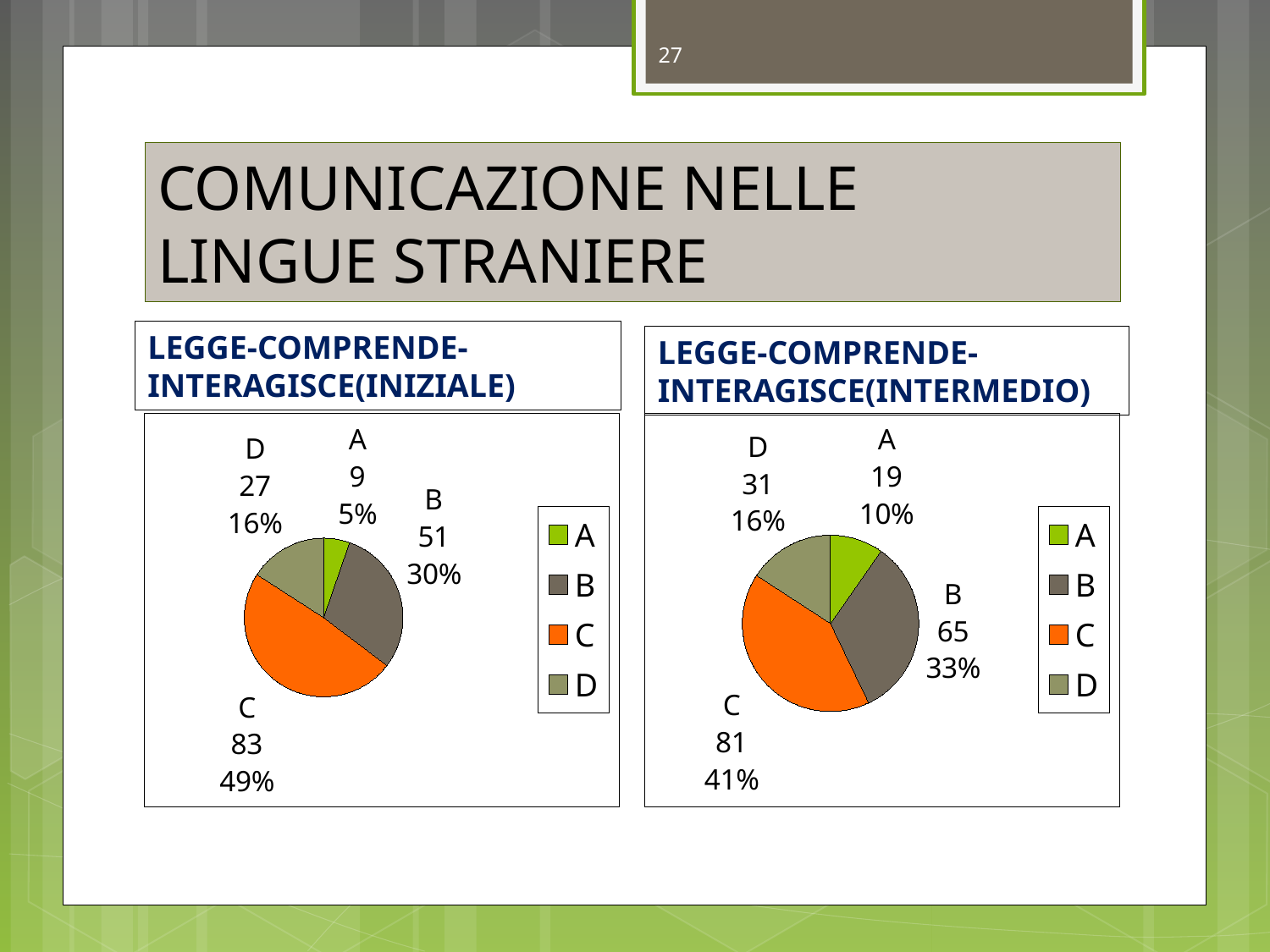
In the LEGGE-COMPRENDE-INTERAGISCE(INTERMEDIO) chart, which is larger, the value for D or the value for A? D In the LEGGE-COMPRENDE-INTERAGISCE(INTERMEDIO) chart, what is the total of all four values? 196 In the LEGGE-COMPRENDE-INTERAGISCE(INIZIALE) chart, which category has the largest slice? C In the LEGGE-COMPRENDE-INTERAGISCE(INTERMEDIO) chart, which category has the smallest slice? A In the LEGGE-COMPRENDE-INTERAGISCE(INIZIALE) chart, what is the value for C? 83 In the LEGGE-COMPRENDE-INTERAGISCE(INTERMEDIO) chart, what percentage share does A have? 10% How many categories does the LEGGE-COMPRENDE-INTERAGISCE(INIZIALE) chart show? 4 In the LEGGE-COMPRENDE-INTERAGISCE(INIZIALE) chart, what colour is the slice for C? Orange In the LEGGE-COMPRENDE-INTERAGISCE(INIZIALE) chart, what is the difference between the values for C and B? 32 In the LEGGE-COMPRENDE-INTERAGISCE(INIZIALE) chart, what percentage share does D have? 16% What kind of chart is the LEGGE-COMPRENDE-INTERAGISCE(INTERMEDIO) chart? Pie chart In the LEGGE-COMPRENDE-INTERAGISCE(INTERMEDIO) chart, what is the value for B? 65